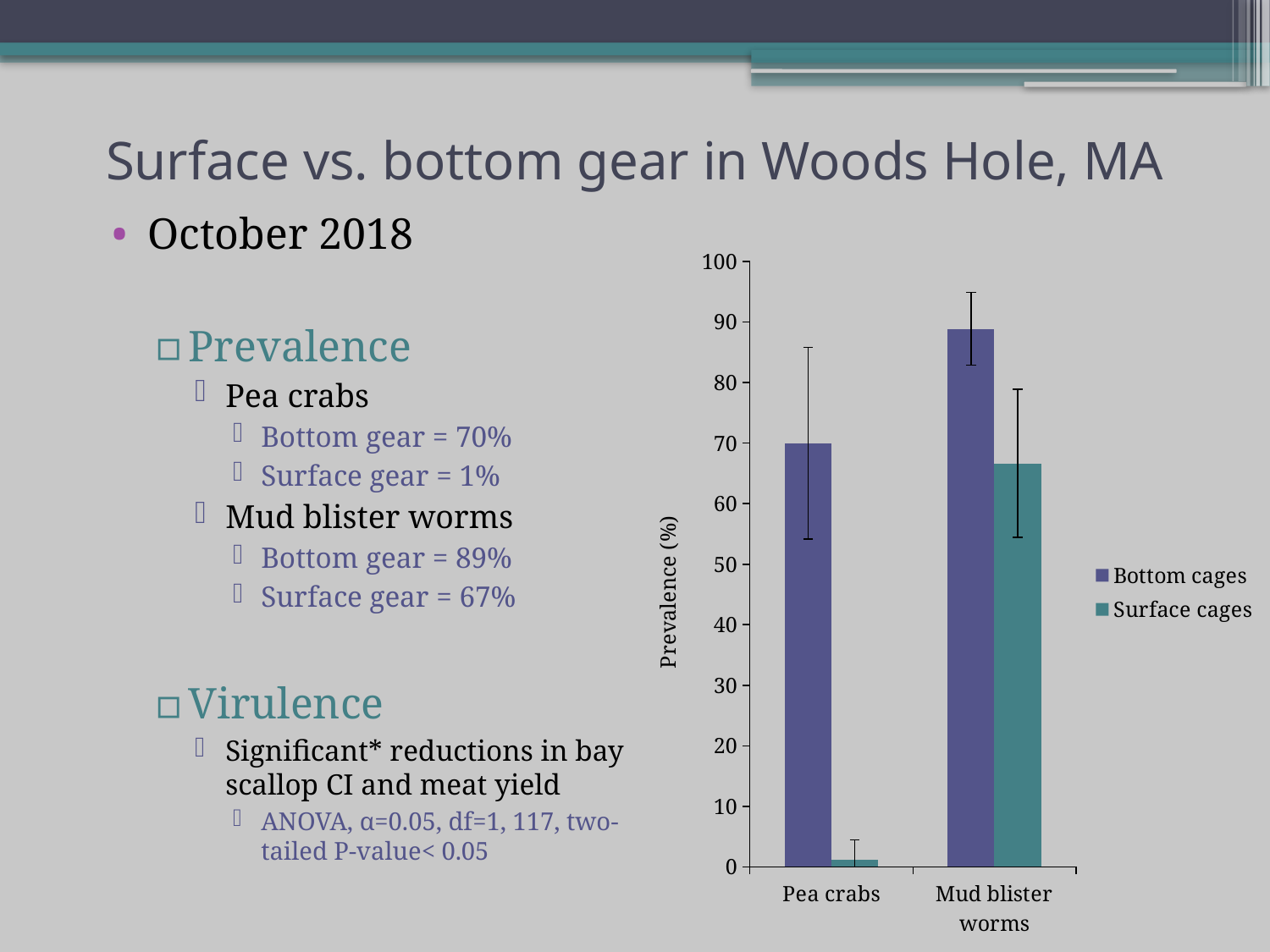
What kind of chart is shown on the slide? bar chart How many series does the chart legend list? 2 What is the prevalence for Bottom cages in the Pea crabs category? 70% Is the Surface cages value for Mud blister worms greater or less than 60? greater Which bar in the chart is the tallest? Bottom cages, Mud blister worms What is the prevalence for Bottom cages in the Mud blister worms category? 89% How many categories are shown on the x axis of the chart? 2 What is the difference between the Bottom cages and Surface cages values for Mud blister worms? 22% What is the prevalence for Surface cages in the Mud blister worms category? 67% Which bar in the chart is the shortest? Surface cages, Pea crabs What is the label on the y axis of the chart? Prevalence (%) What is the prevalence for Surface cages in the Pea crabs category? 1%